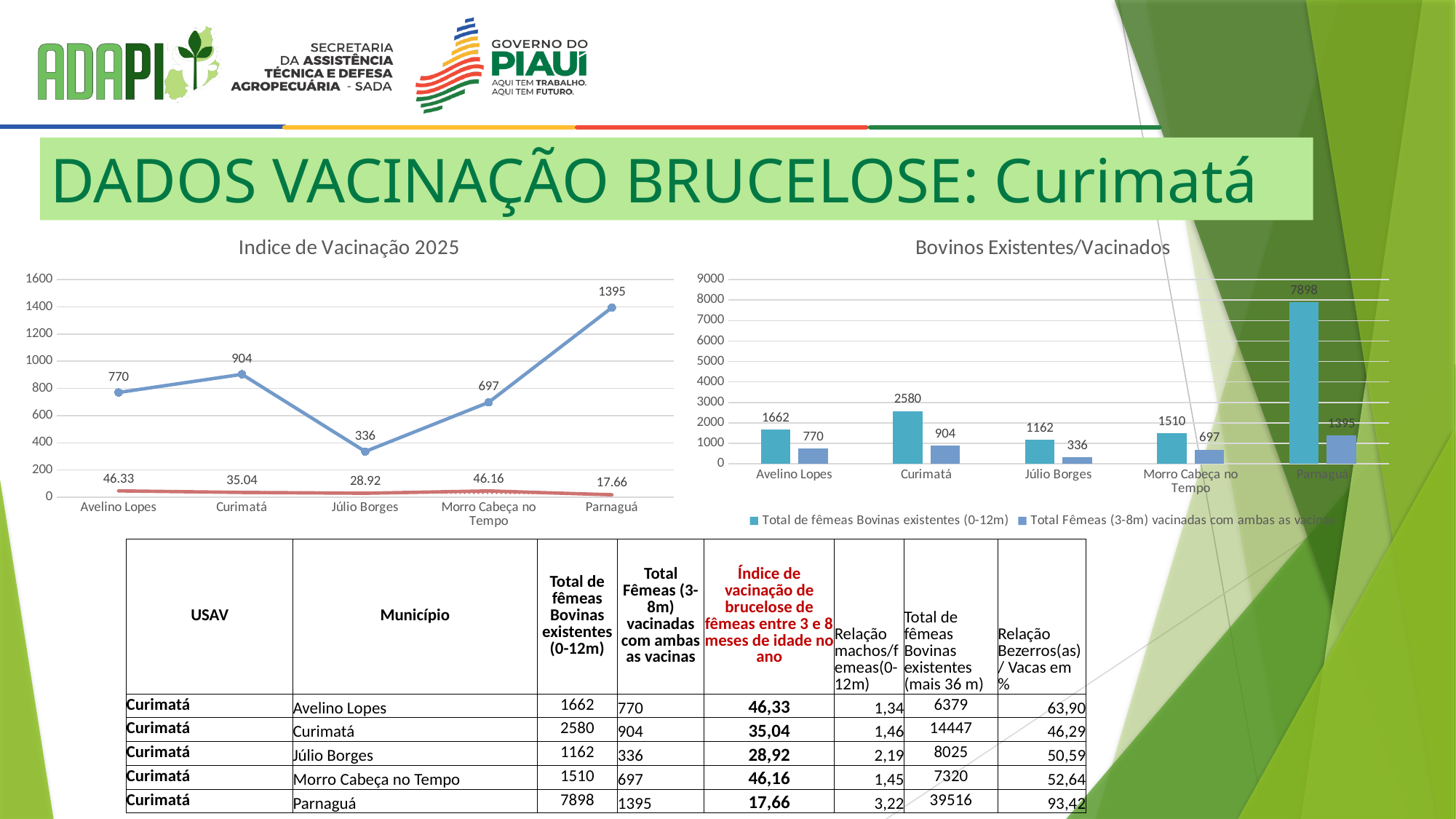
In the 'Indice de Vacinação 2025' chart, what is the value of the lower (red) line for Parnaguá? 17.66 In the 'Bovinos Existentes/Vacinados' chart, which municipality has the highest value for 'Total de fêmeas Bovinas existentes (0-12m)'? Parnaguá In the 'Bovinos Existentes/Vacinados' chart, what is the value of 'Total Fêmeas (3-8m) vacinadas com ambas as vacinas' for Júlio Borges? 336 In the 'Bovinos Existentes/Vacinados' chart, how many series does the legend list? 2 In the 'Indice de Vacinação 2025' chart, how many municipalities are shown on the x axis? 5 In the 'Bovinos Existentes/Vacinados' chart, what is the difference between the two series for Curimatá? 1676 In the 'Bovinos Existentes/Vacinados' chart, which municipality has the lowest value for 'Total de fêmeas Bovinas existentes (0-12m)'? Júlio Borges What kind of chart is 'Bovinos Existentes/Vacinados'? Bar chart What kind of chart is 'Indice de Vacinação 2025'? Line chart In the 'Bovinos Existentes/Vacinados' chart, what is the value of 'Total de fêmeas Bovinas existentes (0-12m)' for Parnaguá? 7898 In the 'Indice de Vacinação 2025' chart, which municipality has the lowest value on the lower (red) line? Parnaguá In the 'Indice de Vacinação 2025' chart, what is the value of the upper (blue) line for Morro Cabeça no Tempo? 697